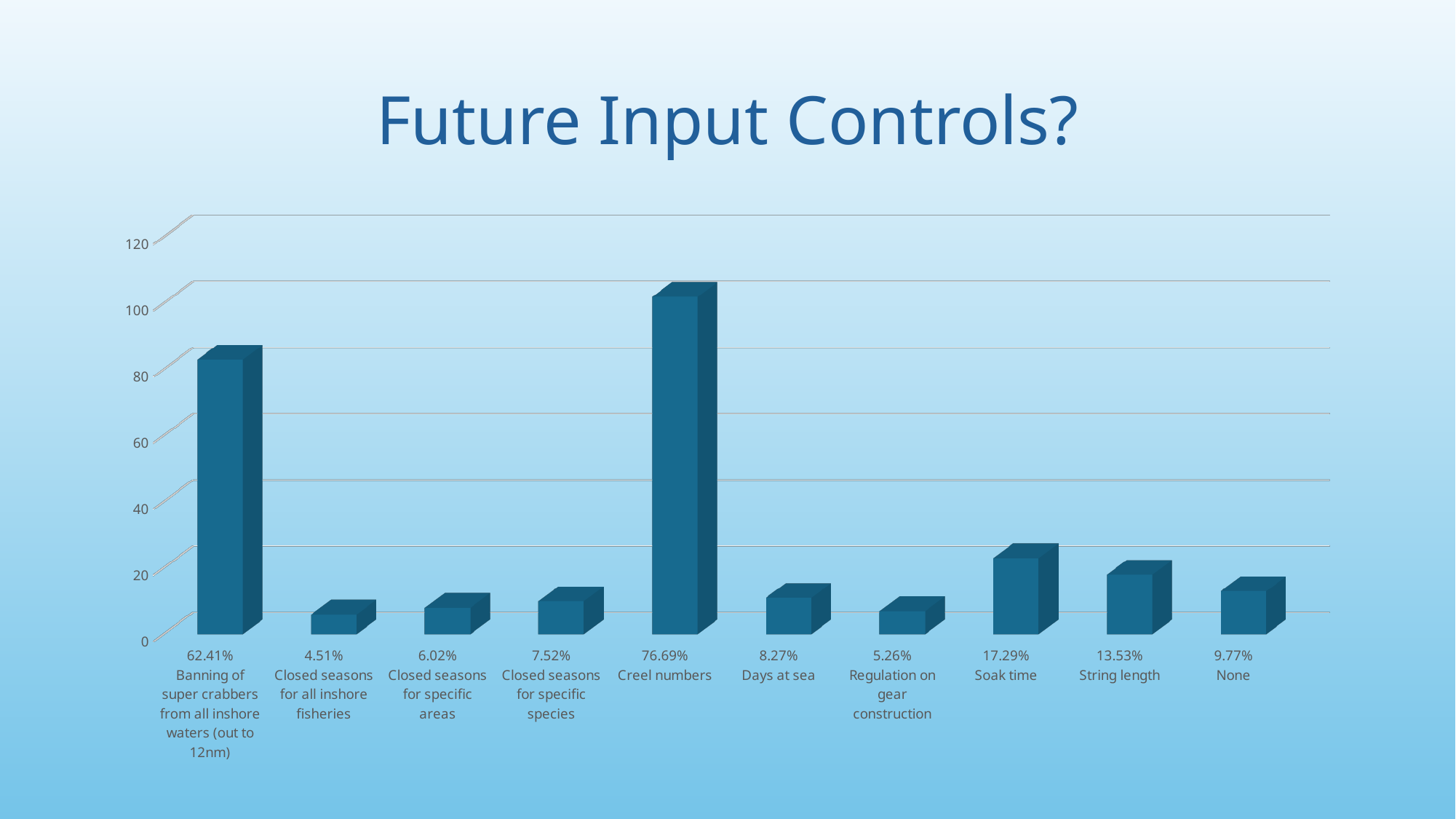
Which category has the lowest bar? Closed seasons for all inshore fisheries What percentage is printed in the label for Soak time? 17.29% Which has the larger bar, Soak time or String length? Soak time What kind of chart is shown on the slide? bar chart How many categories are plotted on the chart? 10 What is the title of the chart? Future Input Controls? Which category has the highest bar? Creel numbers What percentage is printed in the label for None? 9.77% Is the value for Banning of super crabbers from all inshore waters (out to 12nm) greater or less than 60? greater What percentage is printed in the label for Creel numbers? 76.69% Is the value for String length greater or less than 40? less Is the value for Creel numbers greater or less than 80? greater